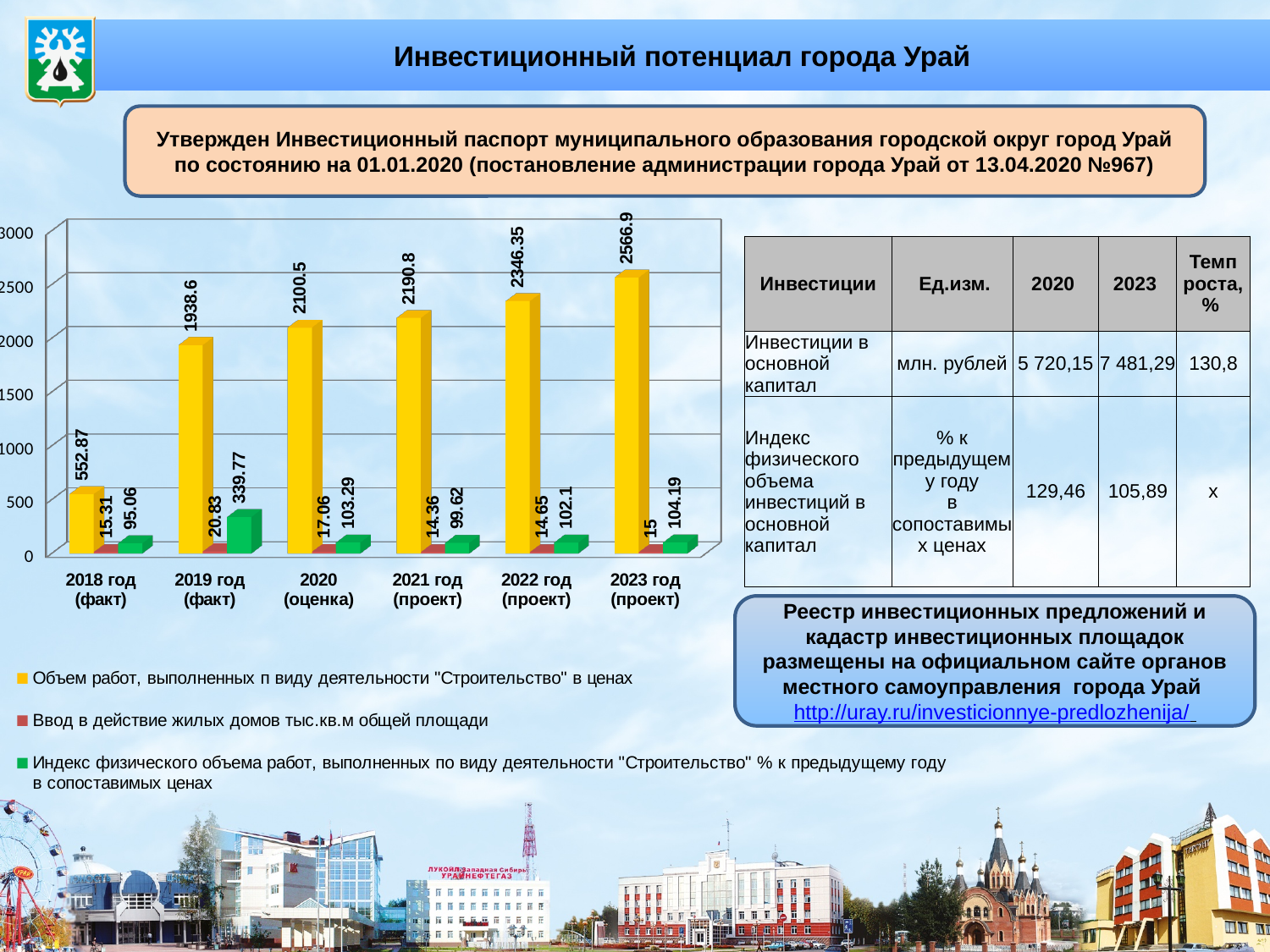
In which year is the value of the series "Индекс физического объема работ" the highest? 2019 год (факт) How many series does the chart legend list? 3 What is the difference between the "Объем работ" values for 2023 год (проект) and 2022 год (проект)? 220.55 In which year is the value of the series "Объем работ, выполненных по виду деятельности "Строительство"" the lowest? 2018 год (факт) What is the value of the series "Индекс физического объема работ" for 2021 год (проект)? 99.62 What is the value of the series "Ввод в действие жилых домов тыс.кв.м общей площади" for 2019 год (факт)? 20.83 What is the value of the series "Объем работ, выполненных по виду деятельности "Строительство" в ценах" for 2023 год (проект)? 2566.9 Does the series "Объем работ, выполненных по виду деятельности "Строительство"" rise or fall from 2018 to 2023? rise Is the "Объем работ" value for 2020 (оценка) greater or less than 2000? greater Which is larger: the "Ввод в действие жилых домов" value for 2018 год (факт) or for 2021 год (проект)? 2018 год (факт) What kind of chart is shown on the slide? bar chart How many year categories are shown on the x axis of the chart? 6